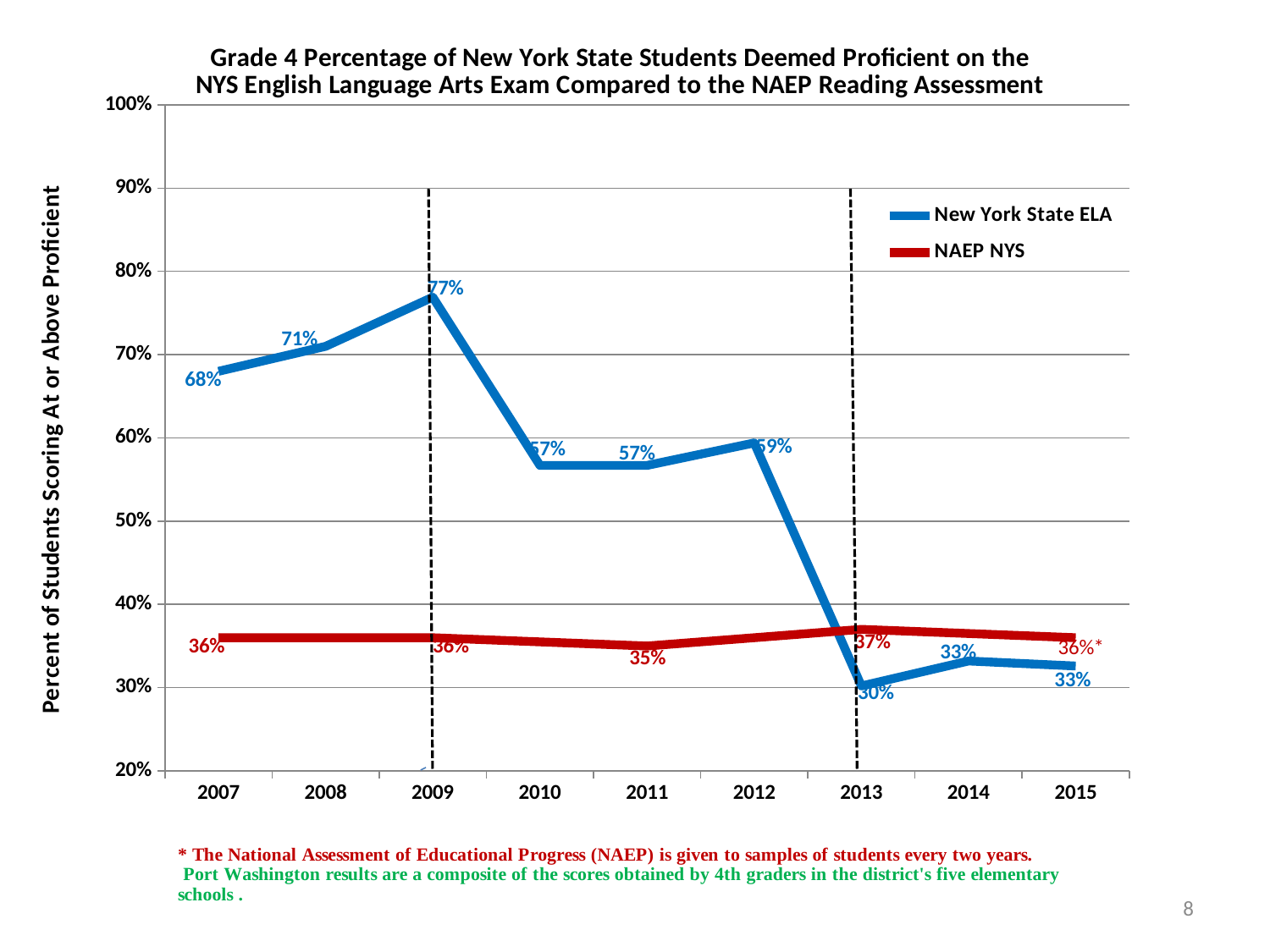
What is the difference between the New York State ELA values for 2009 and 2010? 20 percentage points What is the NAEP NYS value for 2011? 35% How many series does the legend list? 2 In which year is the New York State ELA series at its lowest? 2013 What kind of chart is shown on the slide? Line chart Does the New York State ELA series rise or fall from 2009 to 2013? Fall In 2013, which series has the higher value, New York State ELA or NAEP NYS? NAEP NYS In which year is the New York State ELA series at its highest? 2009 How many years are shown on the x axis? 9 What is the difference between the New York State ELA and NAEP NYS values in 2007? 32 percentage points What is the New York State ELA value for 2009? 77% What is the NAEP NYS value for 2013? 37%